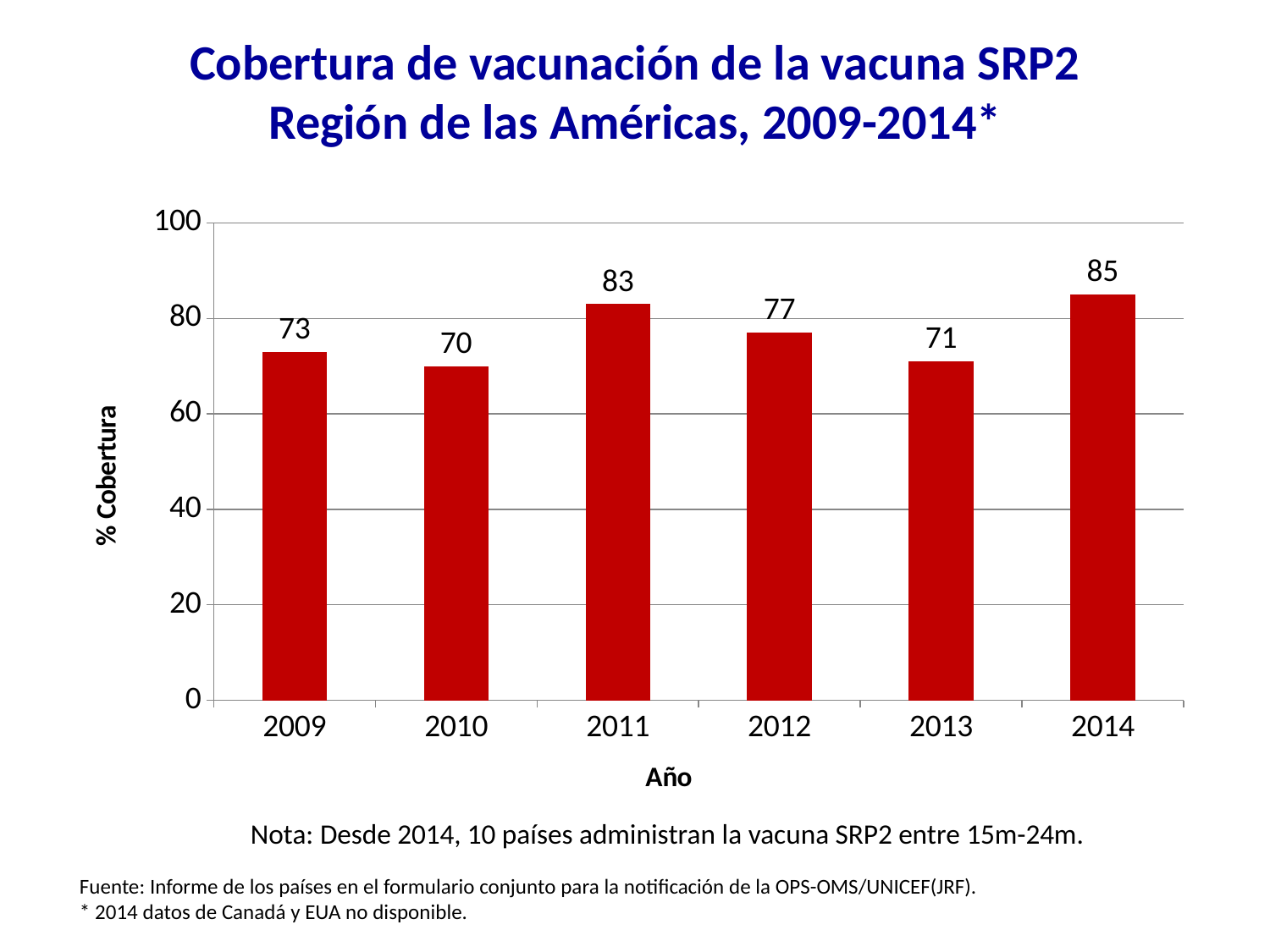
What is the difference between the coverage in 2014 and in 2010? 15 Which year has the highest coverage? 2014 What is the coverage value for 2009? 73 What kind of chart is shown on the slide? Bar chart What is the label of the y axis? % Cobertura What is the difference between the coverage in 2011 and in 2012? 6 How many years are shown on the x axis? 6 What is the coverage value for 2011? 83 What is the coverage value for 2013? 71 Is the value for 2014 greater or less than 80? greater Which year has the lowest coverage? 2010 Which year has higher coverage, 2009 or 2012? 2012